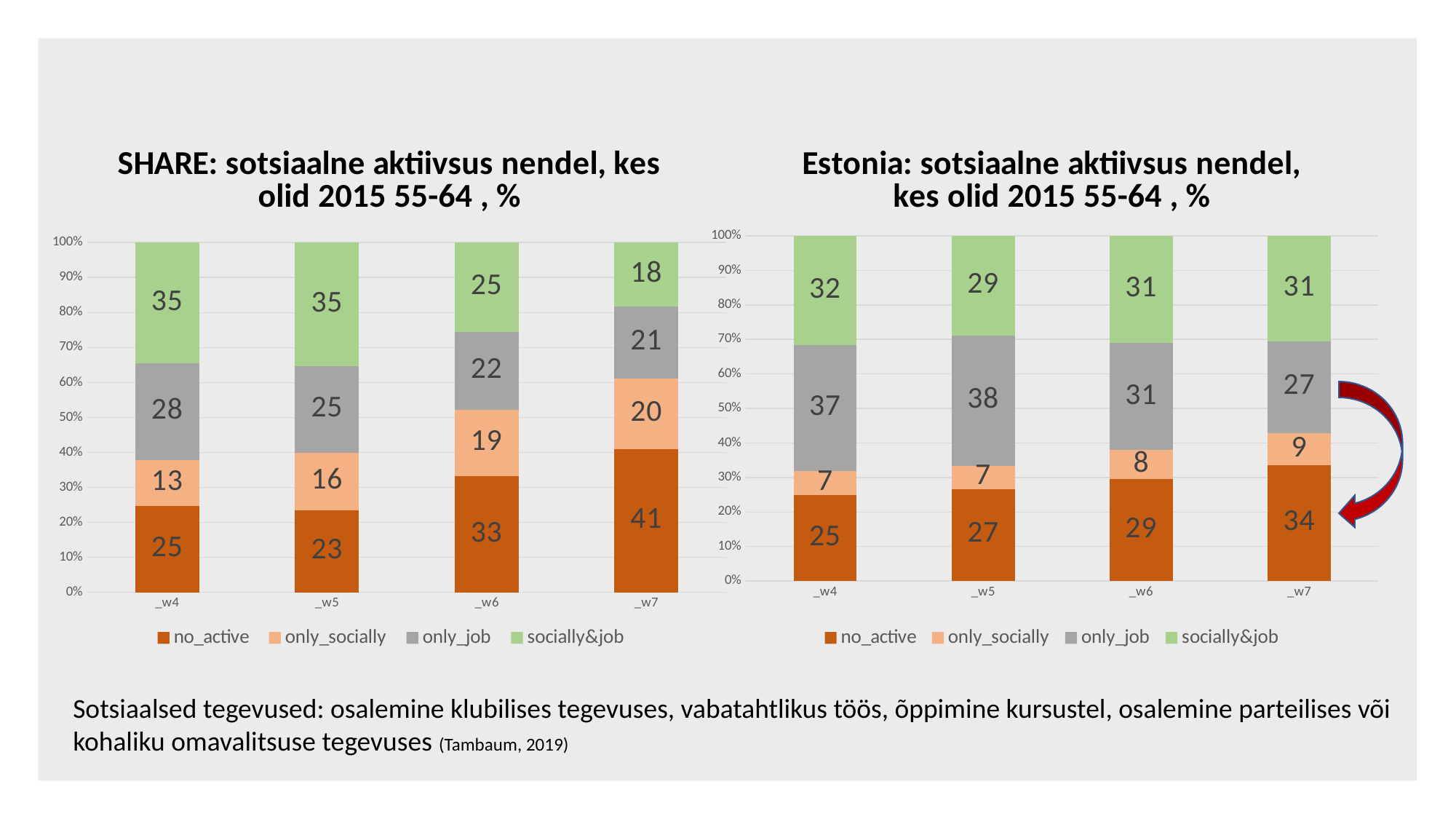
In the SHARE chart on the left, what is the value of no_active for _w7? 41 In the Estonia chart on the right, which wave has the lowest only_job value? _w7 What type of chart is the Estonia chart on the right? Stacked bar chart In the Estonia chart on the right, what is the value of only_socially for _w7? 9 In the SHARE chart on the left, what is the value of socially&job for _w6? 25 How many waves (categories) are shown on the x axis of the Estonia chart on the right? 4 In the SHARE chart on the left, which is larger for _w5: only_job or only_socially? only_job In the SHARE chart on the left, what is the difference between the socially&job values for _w4 and _w7? 17 In the SHARE chart on the left, which wave has the highest no_active value? _w7 How many series does the legend of the SHARE chart on the left list? 4 In the Estonia chart on the right, what is the difference between the no_active values for _w7 and _w4? 9 In the Estonia chart on the right, what is the value of only_job for _w5? 38